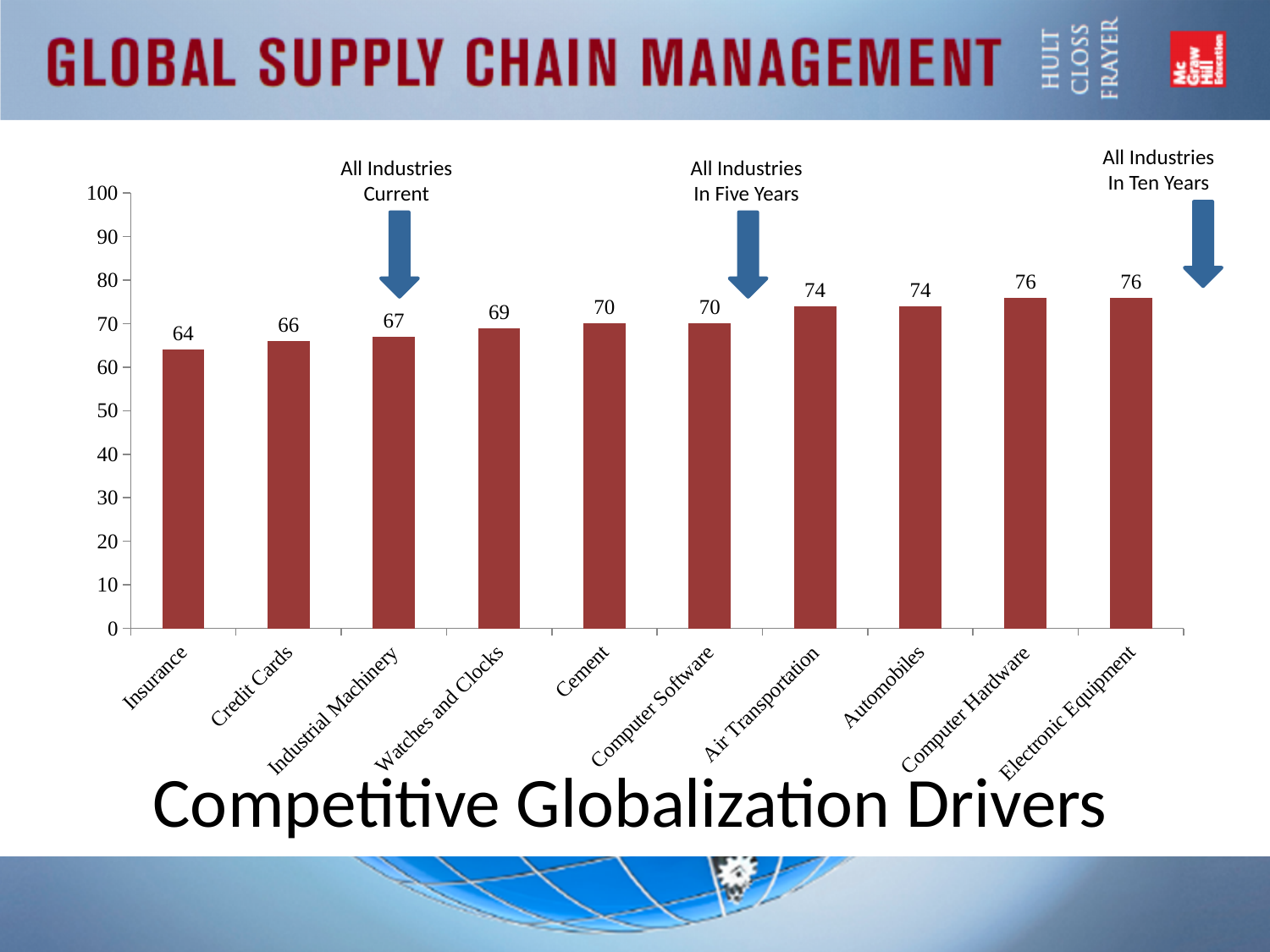
Which category has the lowest value? Insurance What is the value for Watches and Clocks? 69 What kind of chart is shown on the slide? bar chart What is the difference between the values for Automobiles and Credit Cards? 8 Is the value for Credit Cards greater or less than 70? less What is the value for Electronic Equipment? 76 How many categories are shown on the x axis? 10 What is the value for Air Transportation? 74 Which is larger, the value for Cement or the value for Industrial Machinery? Cement What is the difference between the values for Computer Hardware and Insurance? 12 What is the title of the chart? Competitive Globalization Drivers What is the value for Insurance? 64